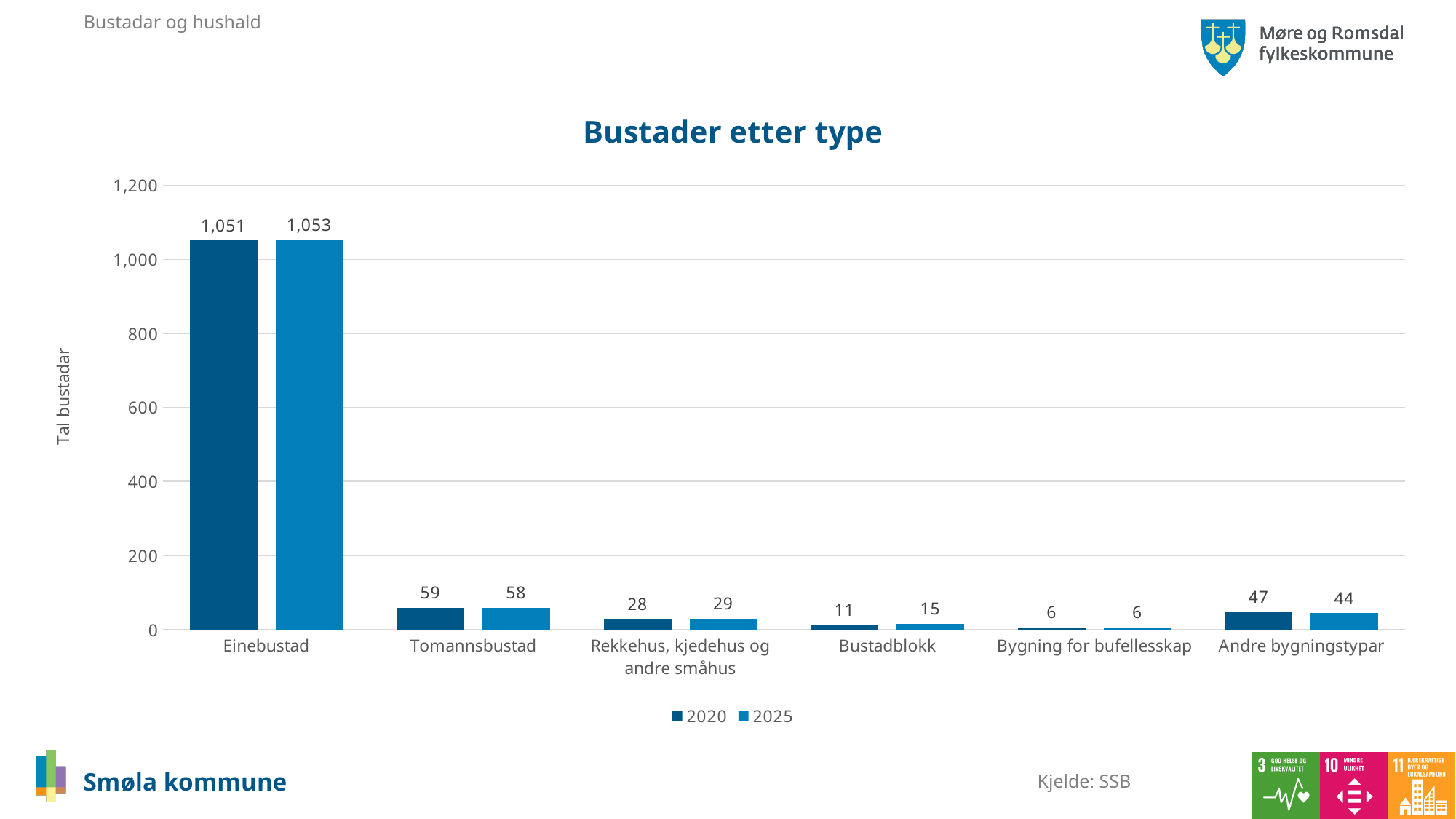
Which category has the lowest value in 2025? Bygning for bufellesskap What is the difference between the 2020 and 2025 values for Bustadblokk? 4 How many categories are shown on the x axis? 6 What is the value for Einebustad in 2025? 1,053 What is the value for Andre bygningstypar in 2020? 47 Which category has the highest value in 2020? Einebustad How many series does the legend list? 2 Is the value for Einebustad in 2020 greater or less than 1,000? greater What is the value for Bustadblokk in 2025? 15 What kind of chart is shown? bar chart Which is larger for Andre bygningstypar: the 2020 value or the 2025 value? 2020 What is the value for Tomannsbustad in 2020? 59